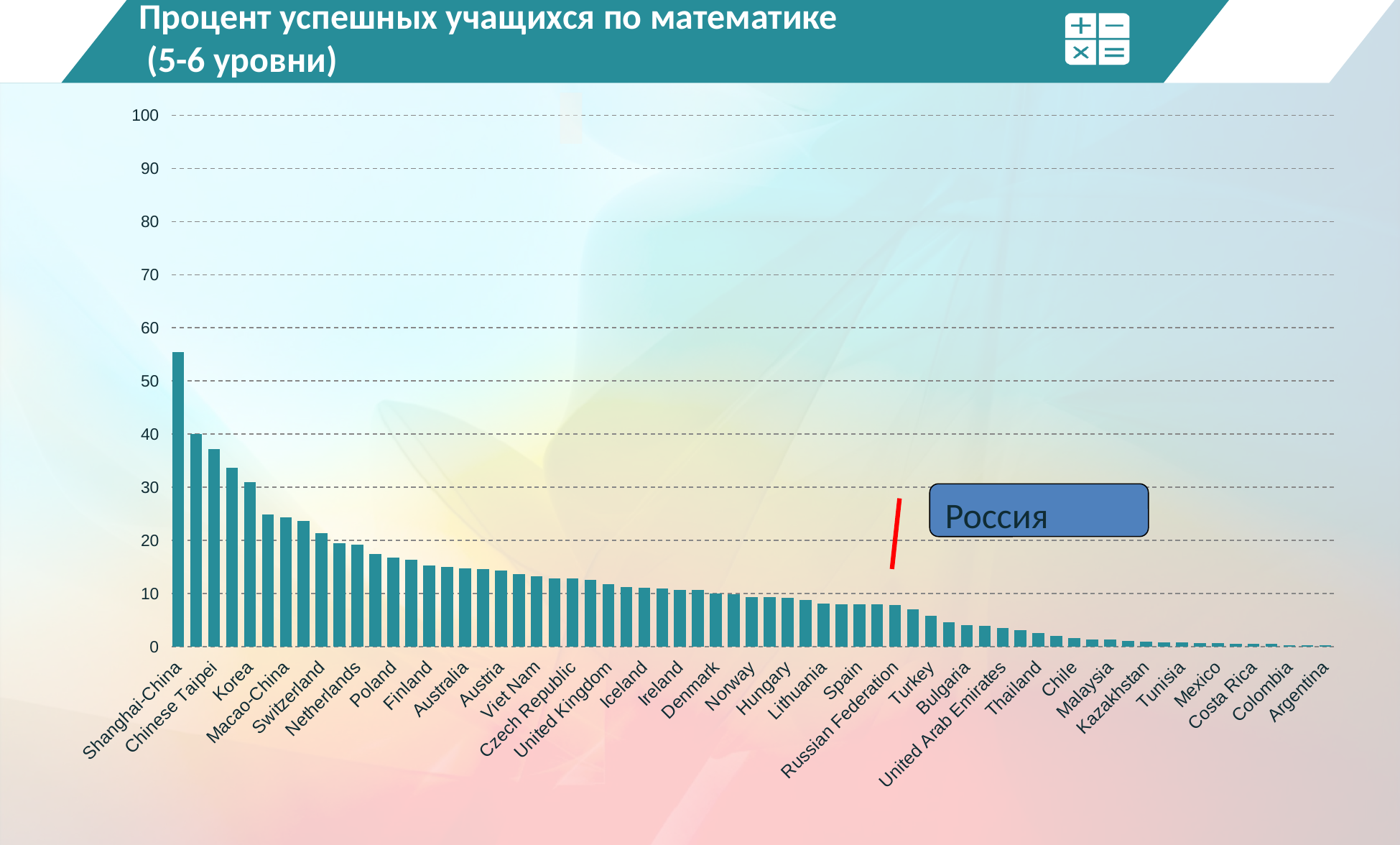
Is the value for Chinese Taipei greater or less than 30? greater Which has a higher value, Finland or Spain? Finland Is the value for Korea greater or less than 20? greater Is the value for Bulgaria greater or less than 10? less What kind of chart is shown on the slide? bar chart Which has a higher value, Korea or Poland? Korea Which country does the callout labelled "Россия" point to? Russian Federation Which country has the highest percentage of successful students in mathematics? Shanghai-China Do the values rise or fall from left to right along the x axis? fall